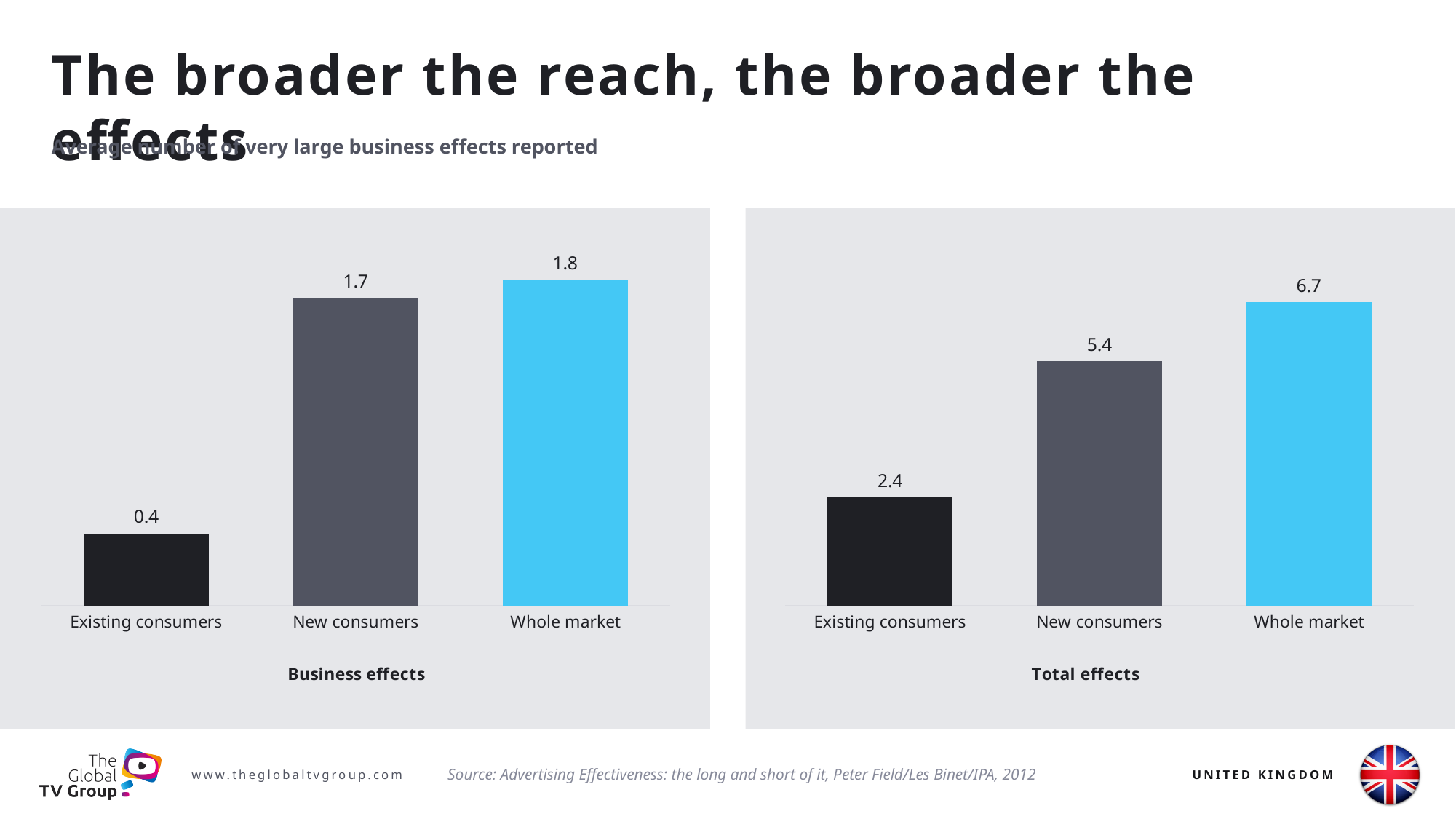
In the Total effects chart, what is the value for Existing consumers? 2.4 In the Business effects chart, what is the difference between Whole market and Existing consumers? 1.4 In the Total effects chart, what is the difference between Whole market and New consumers? 1.3 In the Total effects chart, do the values rise or fall from Existing consumers to Whole market? Rise What colour is the Whole market bar in the Business effects chart? Light blue In the Total effects chart, which category has the lowest value? Existing consumers In the Total effects chart, what is the value for Whole market? 6.7 In the Business effects chart, which category has the highest value? Whole market In the Business effects chart, what is the value for New consumers? 1.7 In the Total effects chart, which is larger: New consumers or Existing consumers? New consumers What kind of chart is the Total effects chart? Bar chart How many categories are shown in the Business effects chart? 3